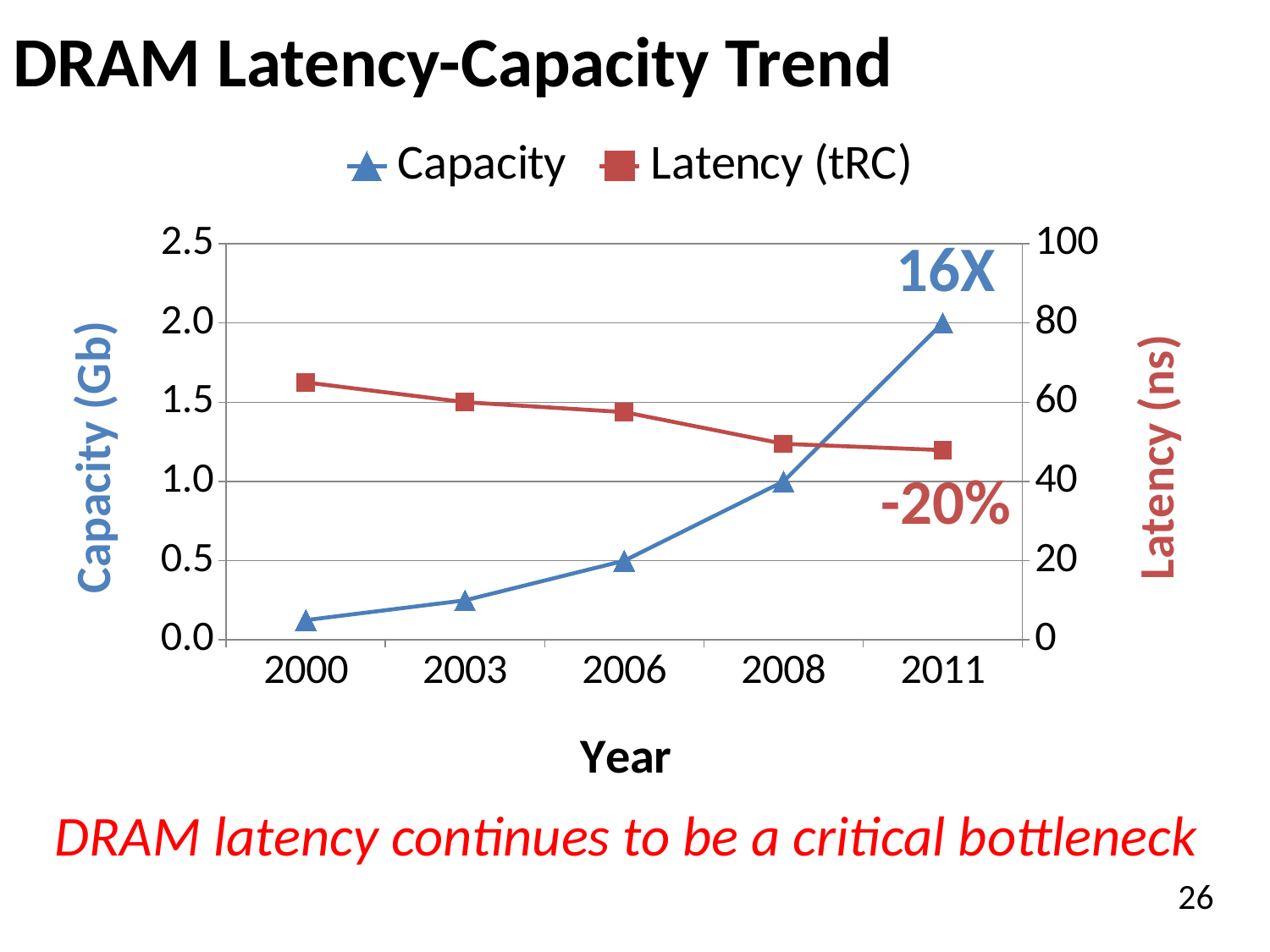
How many years are plotted along the x axis? 5 What is the label of the right-hand vertical axis? Latency (ns) Is the Capacity value for 2011 greater or less than 1.5? greater What kind of chart is shown on the slide? line chart In which year is Latency (tRC) highest? 2000 Does the Capacity series rise or fall from 2000 to 2011? rise How many series does the legend list? 2 In which year is Capacity lowest? 2000 In which year is Capacity highest? 2011 Is the Latency (tRC) value for 2000 greater or less than 60? greater Does the Latency (tRC) series rise or fall from 2000 to 2011? fall Is the Latency (tRC) value for 2011 greater or less than 60? less